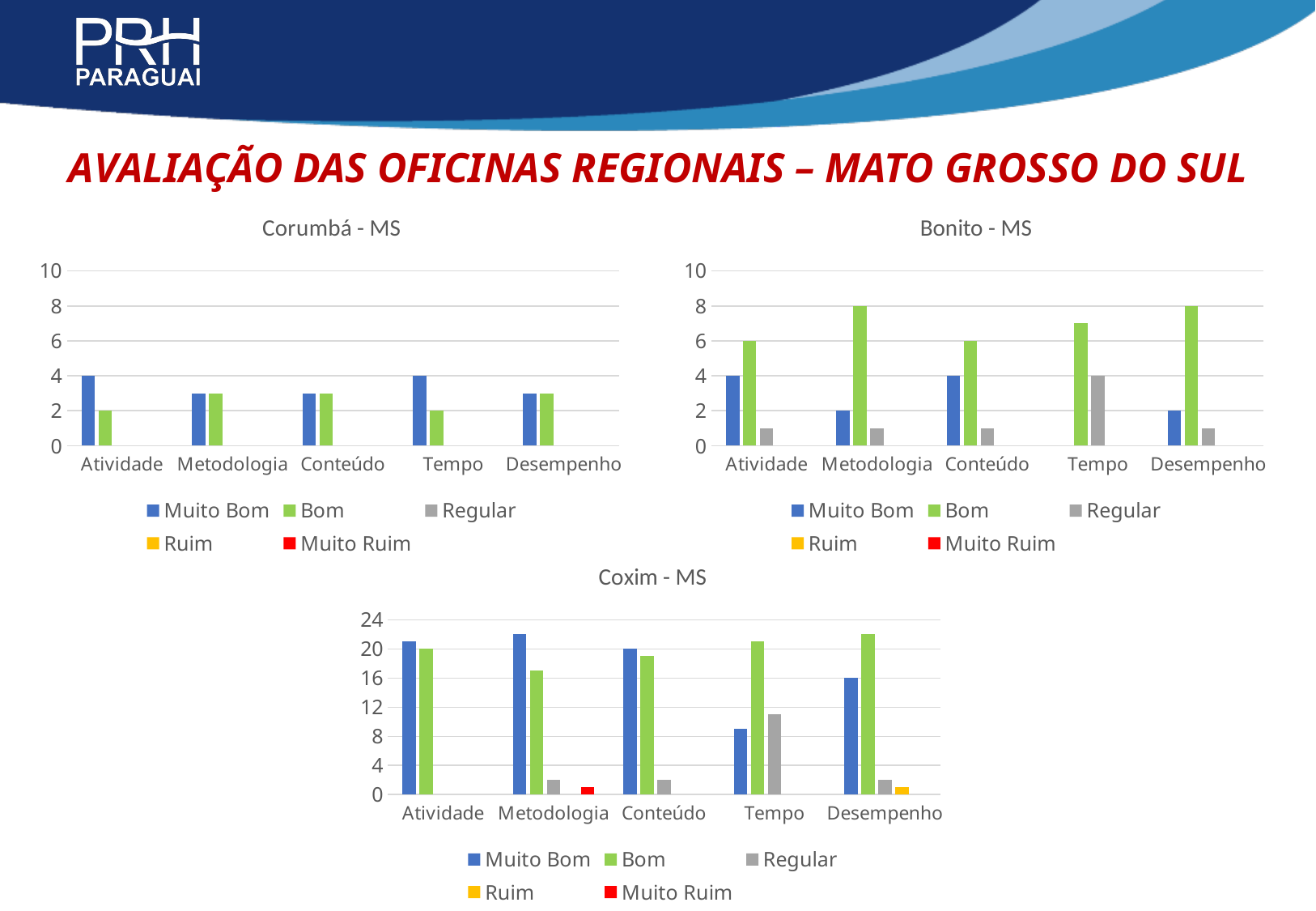
In the Bonito - MS chart, what is the value of Regular for Tempo? 4 In the Bonito - MS chart, what is the difference between Bom and Muito Bom for Desempenho? 6 In the Corumbá - MS chart, what is the value of Bom for Tempo? 2 In the Bonito - MS chart, which category has the highest Regular value? Tempo How many series does the legend of the Coxim - MS chart list? 5 In the Bonito - MS chart, what is the value of Bom for Metodologia? 8 In the Coxim - MS chart, what is the value of Muito Bom for Desempenho? 16 In the Corumbá - MS chart, what is the value of Muito Bom for Atividade? 4 How many categories are shown on the x axis of the Bonito - MS chart? 5 In the Coxim - MS chart, which is larger for Tempo: Muito Bom or Bom? Bom What kind of chart is the Corumbá - MS chart? bar chart In the Coxim - MS chart, is the value of Regular for Tempo greater or less than 8? greater